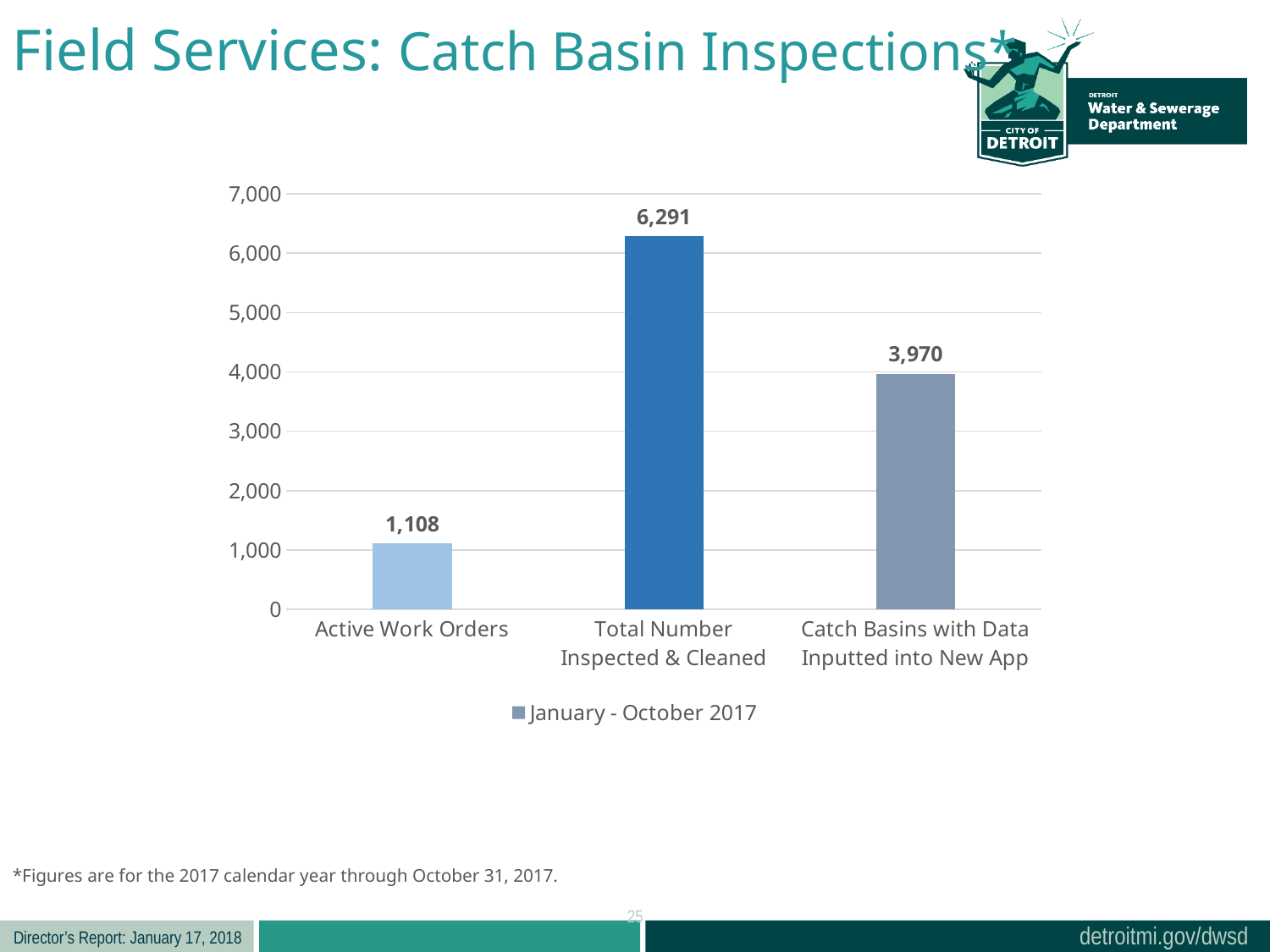
What is the value for Catch Basins with Data Inputted into New App? 3,970 What is the difference between Catch Basins with Data Inputted into New App and Active Work Orders? 2,862 Which category has the lowest value? Active Work Orders What is the value for Total Number Inspected & Cleaned? 6,291 What kind of chart is shown on the slide? Bar chart Which category has the highest value? Total Number Inspected & Cleaned What period does the legend entry refer to? January - October 2017 How many categories are shown on the chart? 3 Which is larger, Active Work Orders or Catch Basins with Data Inputted into New App? Catch Basins with Data Inputted into New App What is the difference between Total Number Inspected & Cleaned and Catch Basins with Data Inputted into New App? 2,321 What is the value for Active Work Orders? 1,108 Is the value for Total Number Inspected & Cleaned greater or less than 6,000? greater